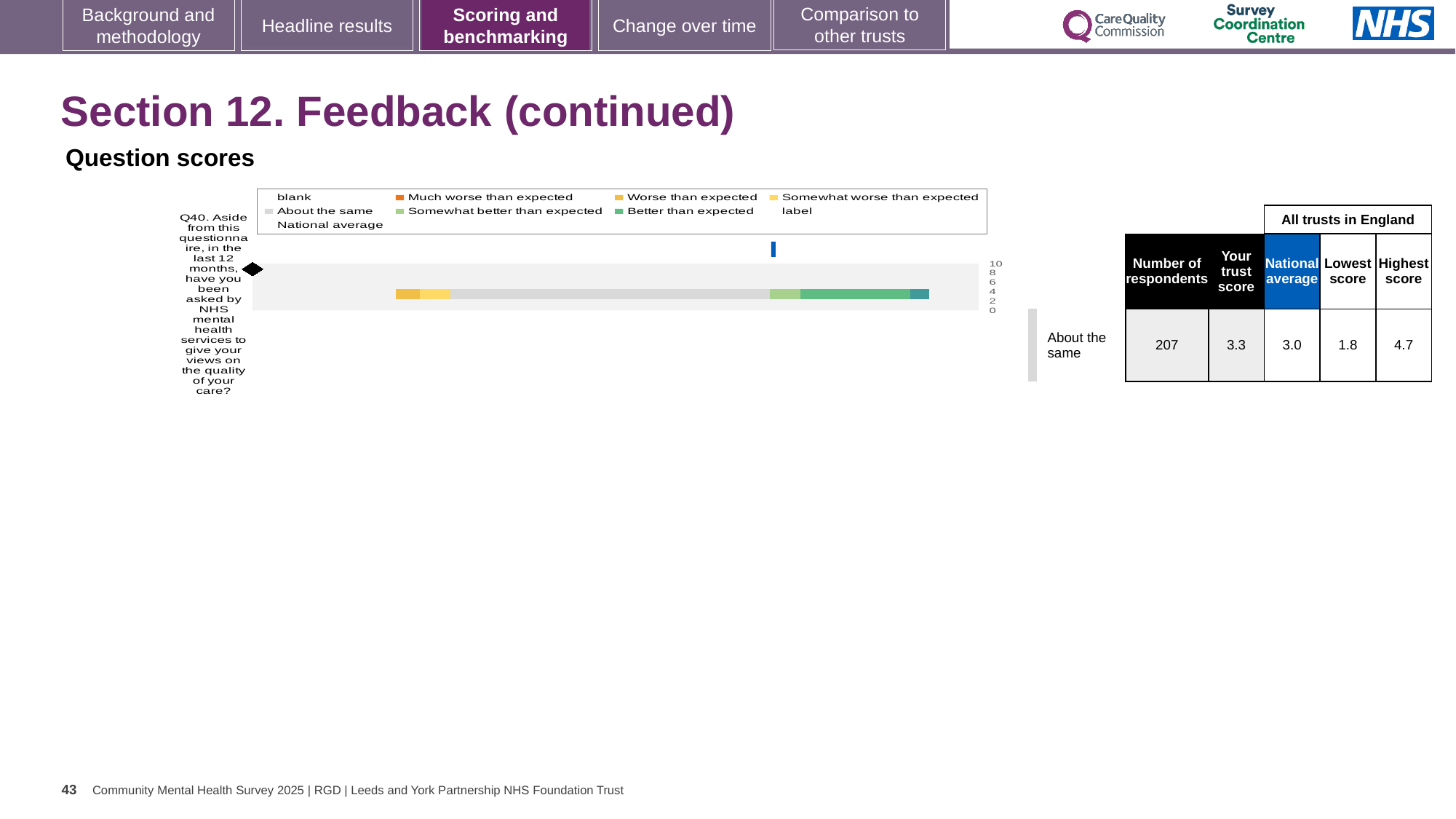
How many entries does the chart legend list? 9 In the table beside the chart, what is the national average for Q40? 3.0 In the table beside the chart, what is the trust's score for Q40? 3.3 How many question categories are plotted on the chart? 1 Which question number is plotted on the chart? Q40 What is the difference between the highest score and the lowest score for Q40 in the table beside the chart? 2.9 Is the trust's score for Q40 larger or smaller than the national average? larger What kind of chart is shown on the slide? bar chart In the table beside the chart, what is the lowest score among all trusts in England for Q40? 1.8 What benchmark category label is shown to the right of the chart for Q40? About the same In the table beside the chart, what is the highest score among all trusts in England for Q40? 4.7 In the table beside the chart, what is the number of respondents for Q40? 207